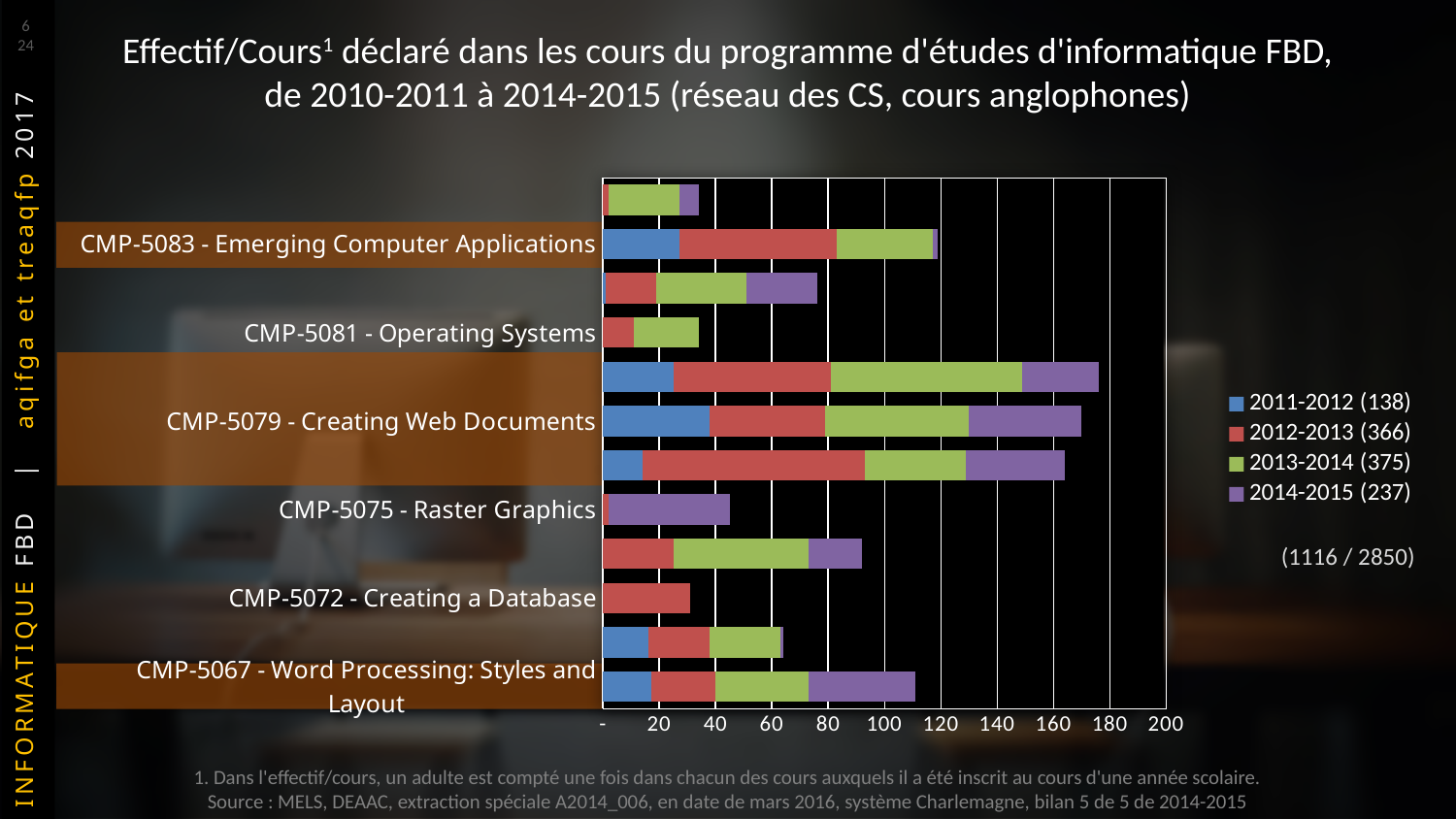
What kind of chart is shown on the slide? Stacked bar chart Is the total bar length for CMP-5075 - Raster Graphics greater or less than 60? less What colour represents the 2014-2015 series in the chart? Purple How many series does the legend list? 4 Is the total bar length for CMP-5083 - Emerging Computer Applications greater or less than 100? greater What number is shown in parentheses next to the legend entry 2012-2013? 366 Which legend entry shows the lowest number in parentheses? 2011-2012 (138) Is the total bar length for CMP-5072 - Creating a Database greater or less than 40? less Which has the longer total bar, CMP-5079 - Creating Web Documents or CMP-5081 - Operating Systems? CMP-5079 - Creating Web Documents What is the difference between the numbers in parentheses for 2013-2014 and 2012-2013 in the legend? 9 Which legend entry shows the highest number in parentheses? 2013-2014 (375)